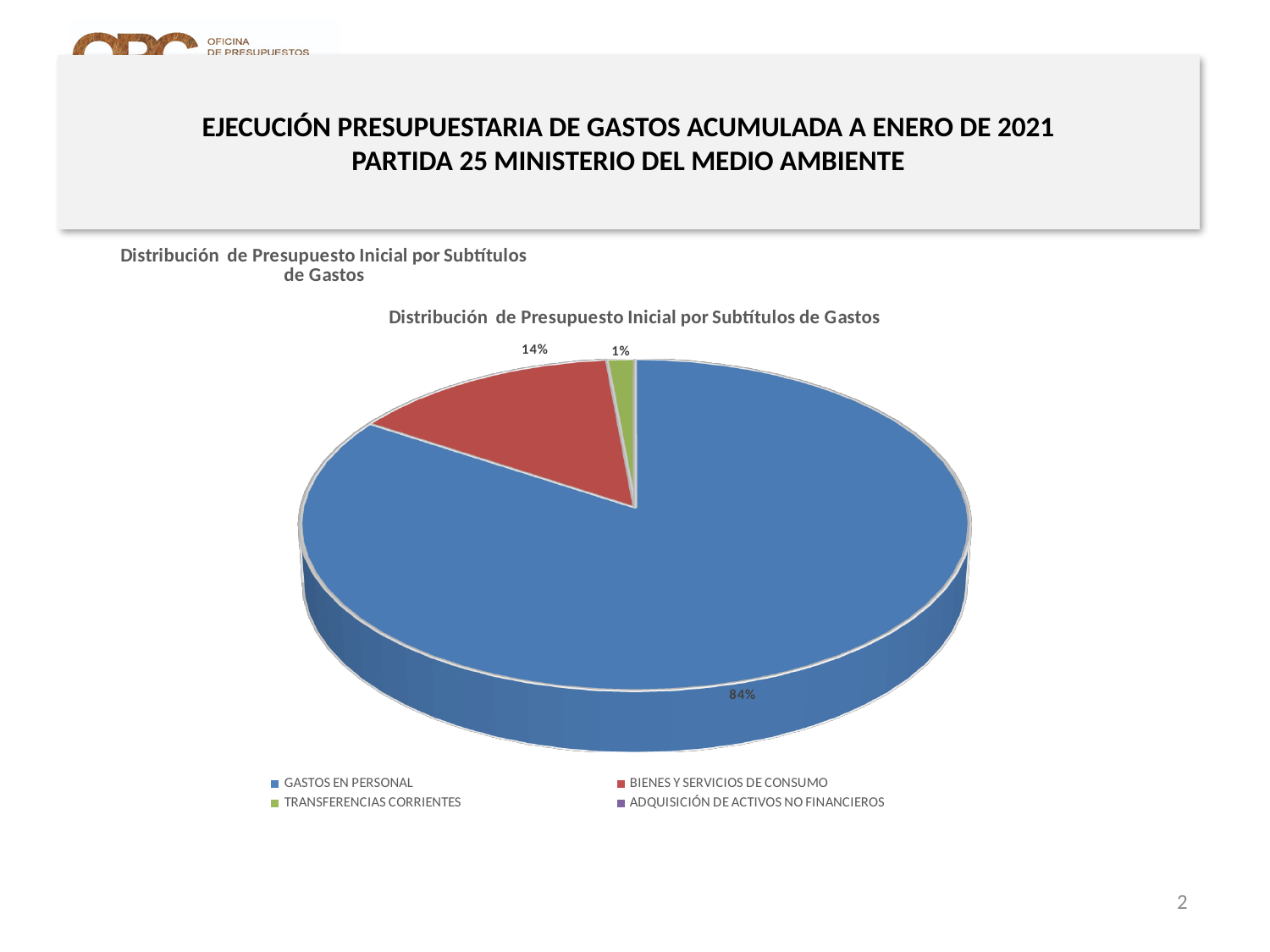
What is the title of the chart? Distribución de Presupuesto Inicial por Subtítulos de Gastos What percentage is shown for TRANSFERENCIAS CORRIENTES? 1% What is the difference in percentage points between GASTOS EN PERSONAL and BIENES Y SERVICIOS DE CONSUMO? 70 percentage points Which category has the largest slice of the pie? GASTOS EN PERSONAL Which is larger, the slice for BIENES Y SERVICIOS DE CONSUMO or the slice for TRANSFERENCIAS CORRIENTES? BIENES Y SERVICIOS DE CONSUMO What percentage is shown for BIENES Y SERVICIOS DE CONSUMO? 14% What colour is the slice for GASTOS EN PERSONAL? Blue What kind of chart is shown on the slide? Pie chart What share of the pie does GASTOS EN PERSONAL represent? 84% Is the share for BIENES Y SERVICIOS DE CONSUMO greater or less than 50%? less How many categories does the legend list? 4